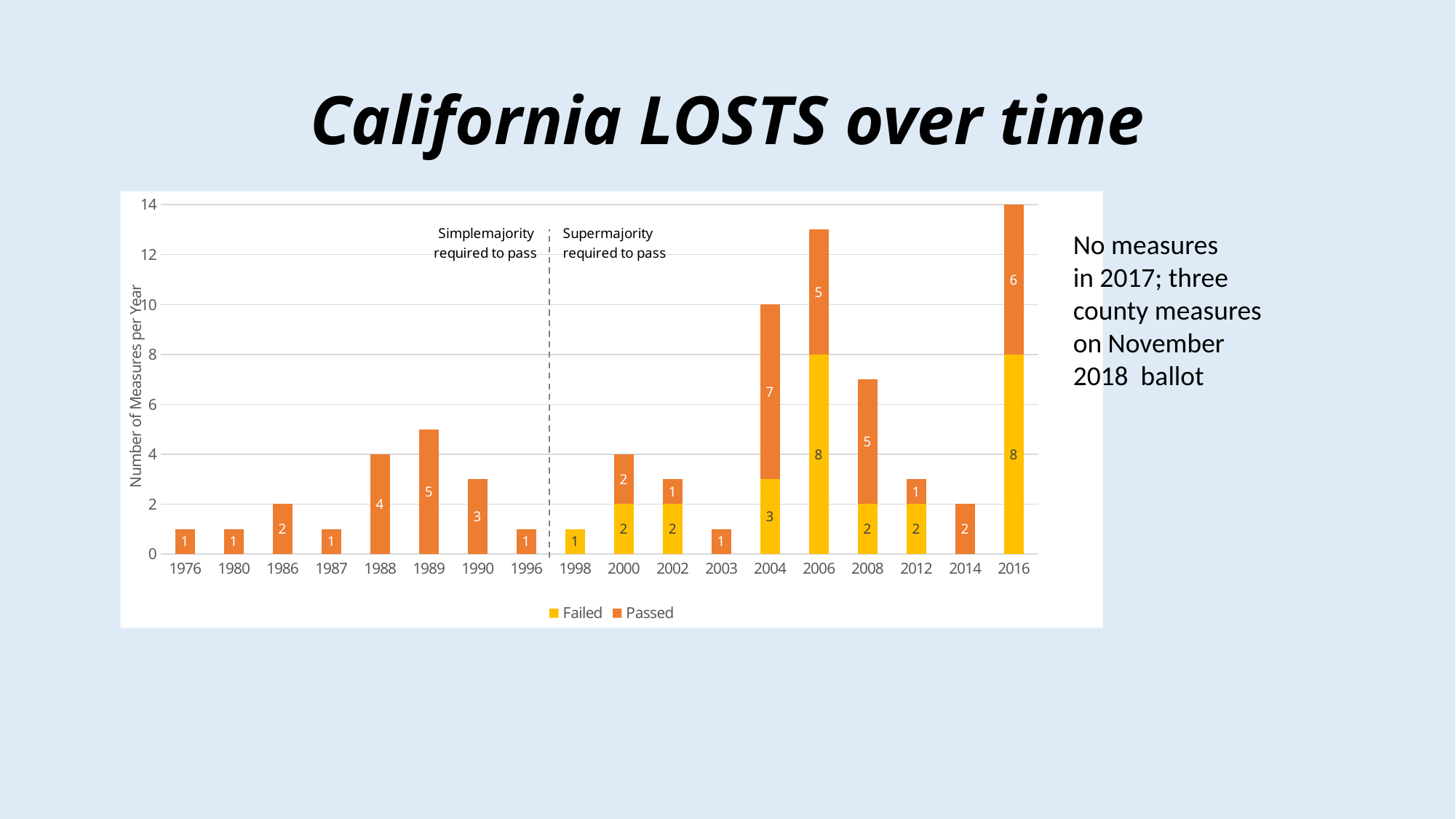
How many series does the legend list? 2 How many measures passed in 1989? 5 What is the label of the y axis? Number of Measures per Year How many years are shown on the x axis? 18 What kind of chart is shown on the slide? Stacked bar chart Which year has the highest total number of measures? 2016 How many measures failed in 2006? 8 How many measures passed in 2004? 7 What is the difference between the number of measures passed in 2004 and the number passed in 2008? 2 What is the total number of measures in 2016? 14 Which is larger: the number of measures passed in 2016 or the number passed in 2006? 2016 What is the total number of measures in 2008? 7